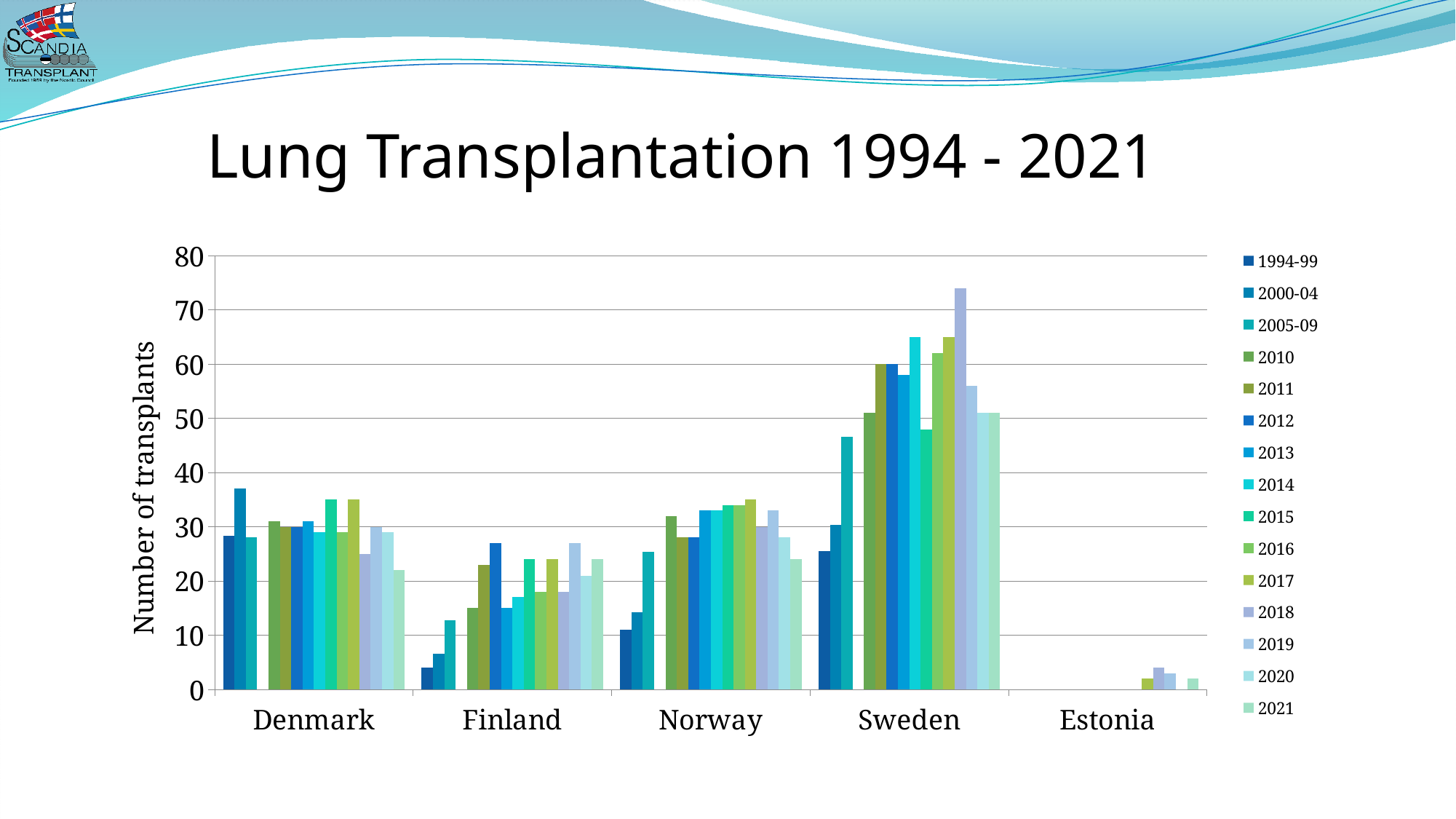
Is the value for Estonia in 2018 greater or less than 10? less What kind of chart is shown on the slide? bar chart Is the value for Finland in 1994-99 greater or less than 10? less Which country has the lowest number of lung transplants in the chart? Estonia How many countries are shown on the x axis of the chart? 5 What is the label on the y axis of the chart? Number of transplants How many series (time periods) does the legend list? 15 Is the value for Sweden in 2018 greater or less than 70? greater Which country has the highest number of lung transplants in the chart? Sweden Which is larger for Sweden: the value for 2018 or the value for 2019? 2018 Which country has the larger value for 2000-04: Finland or Norway? Norway